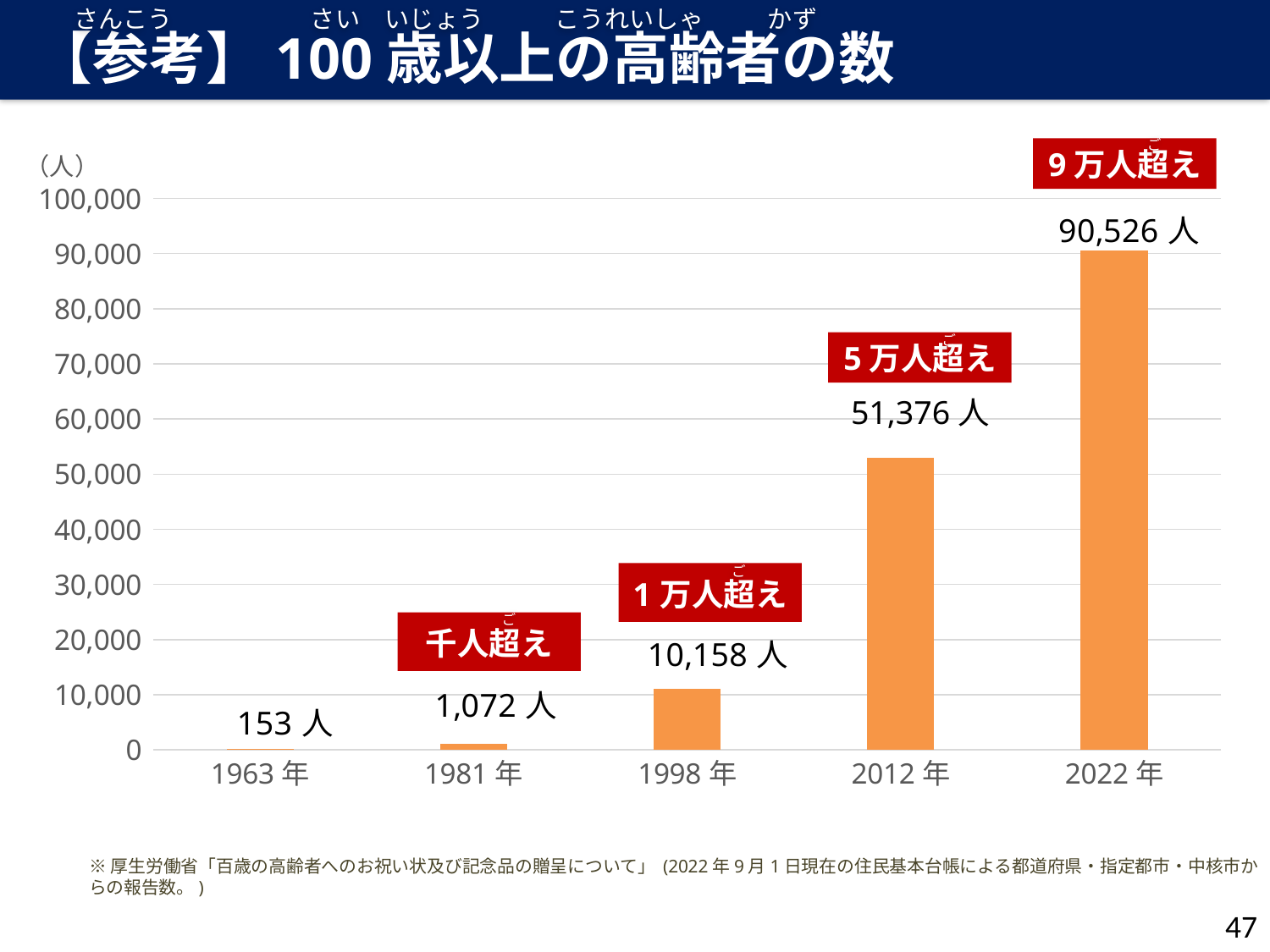
Do the values rise or fall from 1963年 to 2022年? rise Which year has the lowest value? 1963年 What is the title of the chart on the slide? 【参考】100歳以上の高齢者の数 What is the difference between the values for 2022年 and 2012年? 39,150 人 What kind of chart is shown on the slide? bar chart What is the value for 1963年? 153 人 Which year has the highest value? 2022年 What is the value for 1998年? 10,158 人 How many years (categories) are plotted on the chart? 5 What is the value for 1981年? 1,072 人 What is the value for 2022年? 90,526 人 What is the value for 2012年? 51,376 人